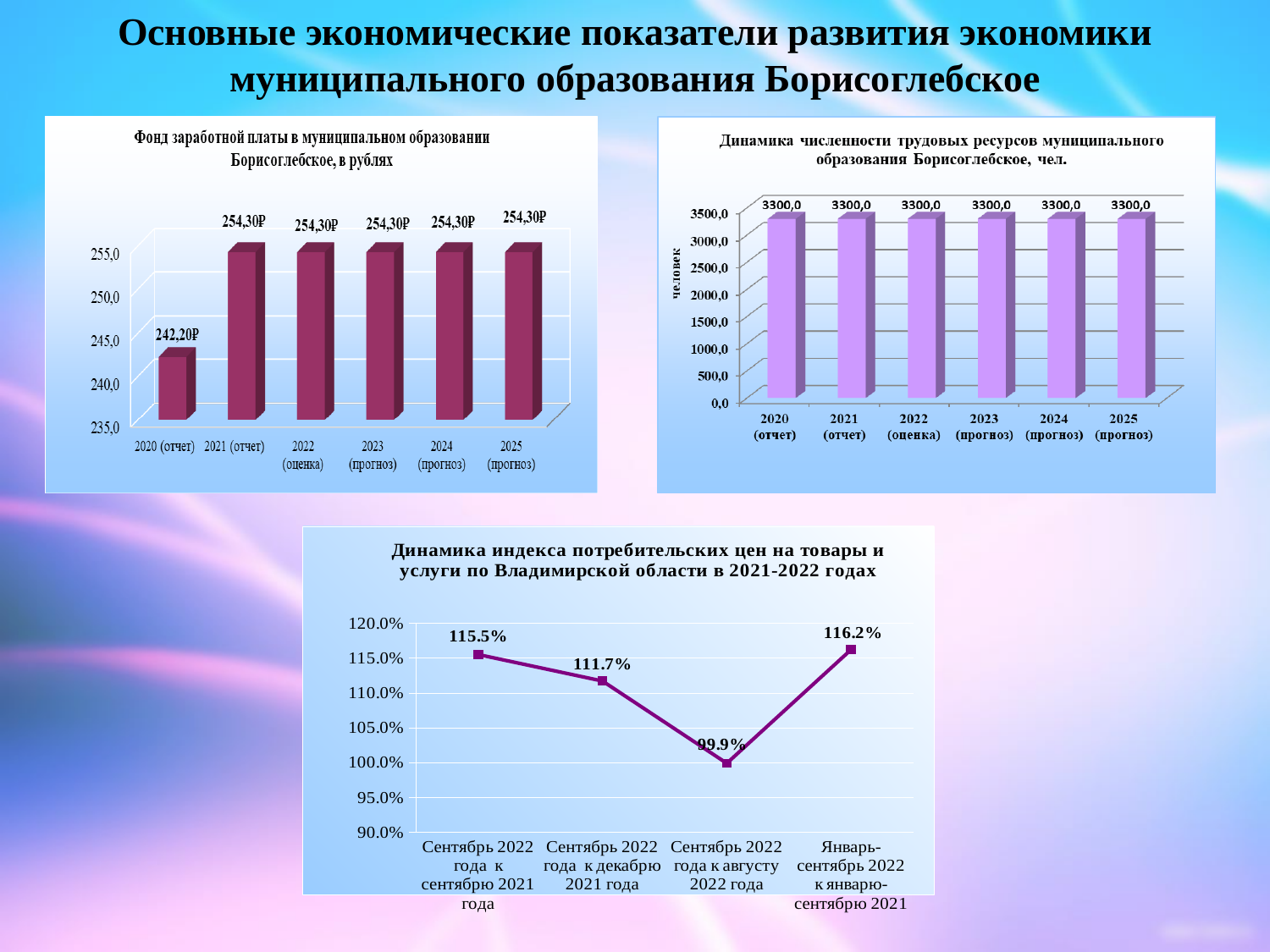
In the chart 'Динамика численности трудовых ресурсов муниципального образования Борисоглебское, чел.', do the values rise, fall or stay the same from 2020 to 2025? stay the same In the bottom chart 'Динамика индекса потребительских цен на товары и услуги по Владимирской области в 2021-2022 годах', what is the difference between 115.5% and 111.7%? 3.8% In the bottom chart 'Динамика индекса потребительских цен на товары и услуги по Владимирской области в 2021-2022 годах', what kind of chart is shown? line chart In the bottom chart 'Динамика индекса потребительских цен на товары и услуги по Владимирской области в 2021-2022 годах', what is the value for 'Сентябрь 2022 года к августу 2022 года'? 99.9% In the bottom chart 'Динамика индекса потребительских цен на товары и услуги по Владимирской области в 2021-2022 годах', which point has the highest value? Январь-сентябрь 2022 к январю-сентябрю 2021 In the chart 'Фонд заработной платы в муниципальном образовании Борисоглебское, в рублях', how many bars are plotted? 6 In the chart 'Фонд заработной платы в муниципальном образовании Борисоглебское, в рублях', which year has the lowest value? 2020 (отчет) In the chart 'Динамика численности трудовых ресурсов муниципального образования Борисоглебское, чел.', what kind of chart is shown? bar chart In the chart 'Фонд заработной платы в муниципальном образовании Борисоглебское, в рублях', what is the difference between the 2021 (отчет) value and the 2020 (отчет) value? 12,10₽ In the chart 'Фонд заработной платы в муниципальном образовании Борисоглебское, в рублях', is the value for 2020 (отчет) greater or less than 245,0? less In the chart 'Фонд заработной платы в муниципальном образовании Борисоглебское, в рублях', what is the value for 2020 (отчет)? 242,20₽ In the chart 'Динамика численности трудовых ресурсов муниципального образования Борисоглебское, чел.', what is the value for 2023 (прогноз)? 3300,0